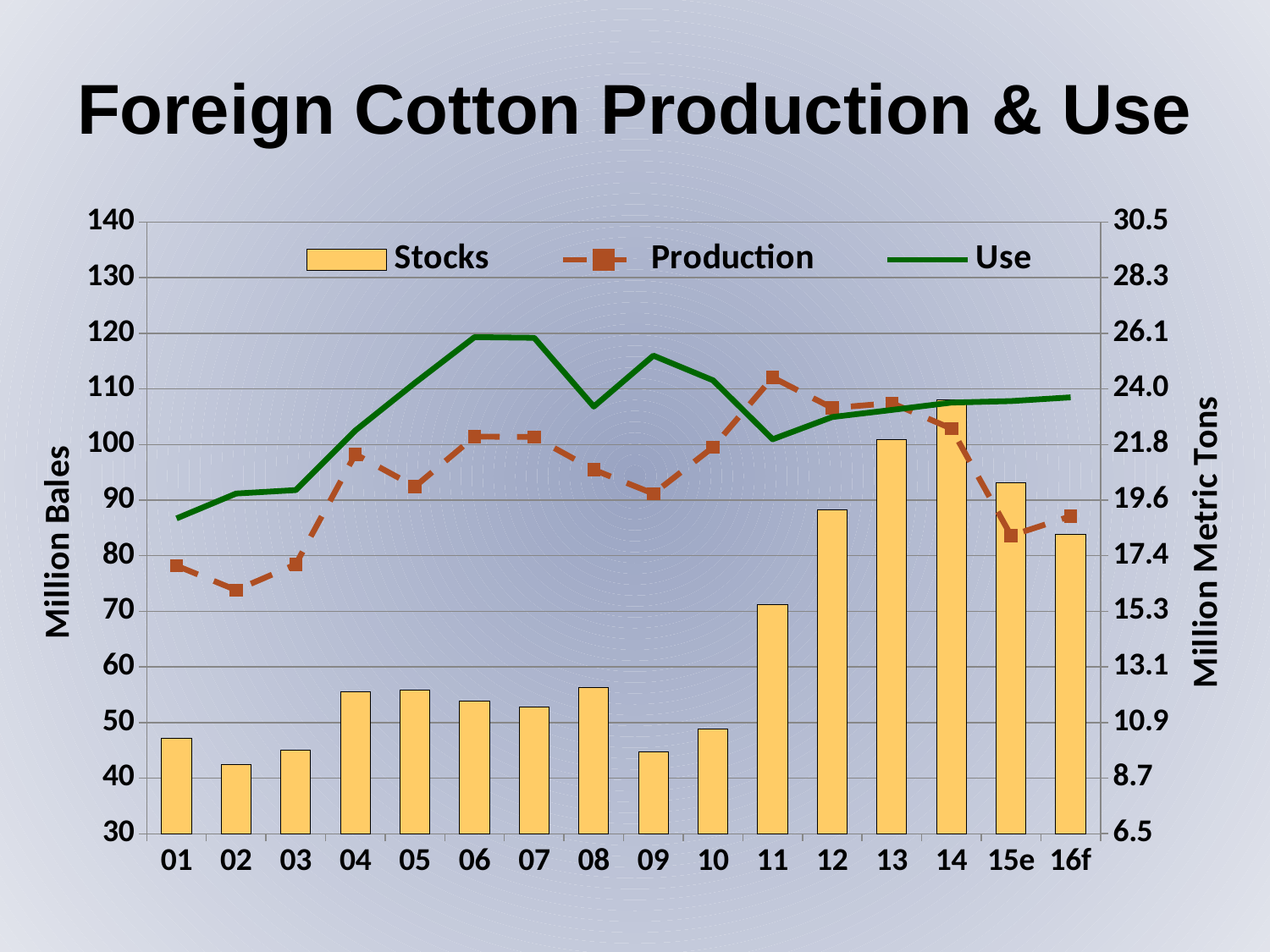
Is the Production value for 02 greater or less than 80? less Do the Stocks bars rise or fall from 10 to 14? rise In 11, which is higher, Production or Use? Production Which year has the highest Stocks bar? 14 What kind of chart is shown on the slide? A combined bar and line chart Is the Stocks value for 14 greater or less than 100? greater In which year does the Production line reach its highest point? 11 In which year is the Use line at its lowest? 01 How many years are shown along the x axis? 16 What is the label on the right-hand vertical axis? Million Metric Tons Is the Stocks value for 11 greater or less than 80? less How many series does the legend list? 3